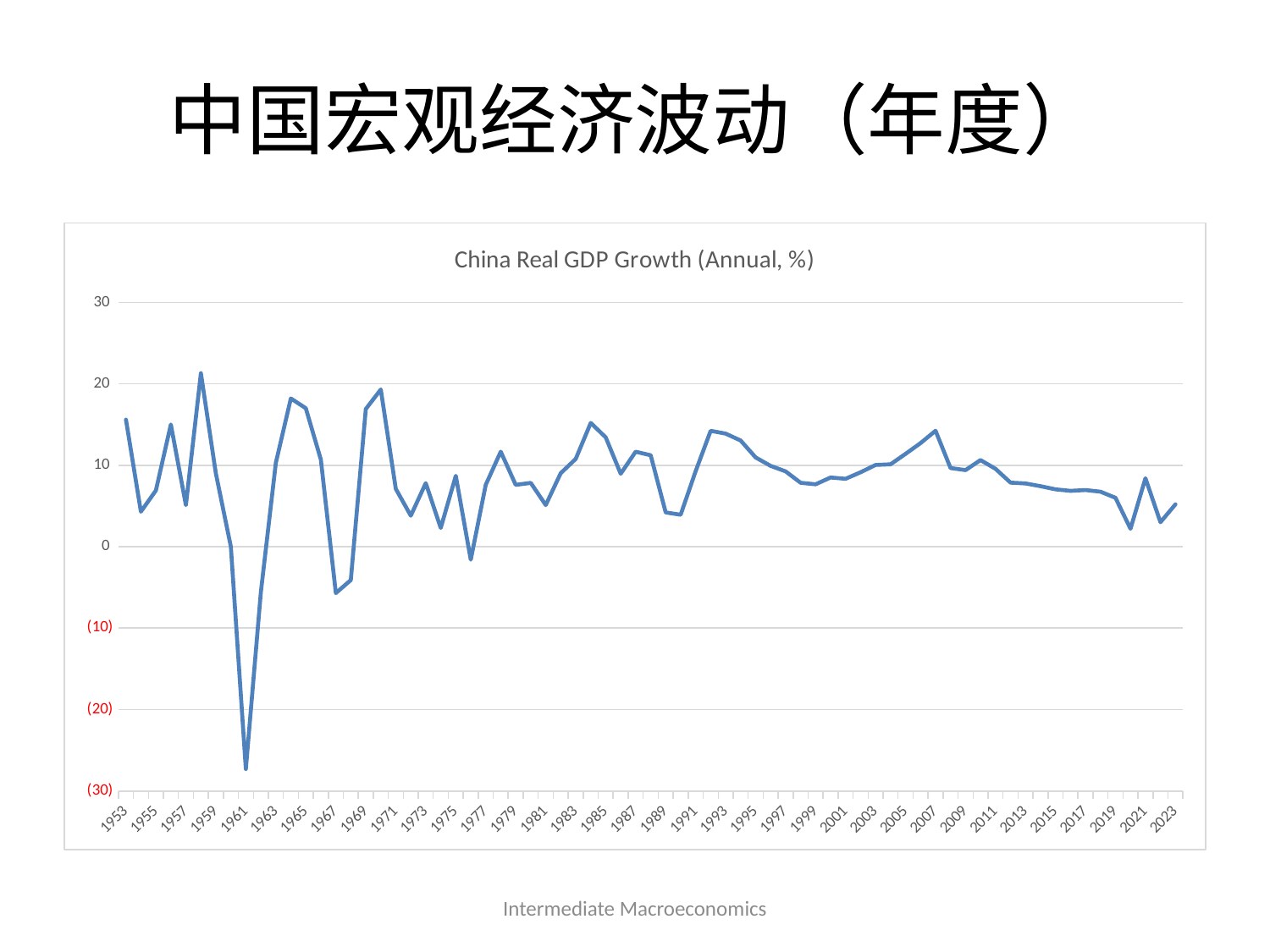
Is the value for 1984 greater or less than 10? greater What kind of chart is shown on the slide? line chart In which year does China's real GDP growth reach its highest point? 1958 In which year does China's real GDP growth reach its lowest point? 1961 Is the value for 2007 greater or less than 10? greater Is the value for 1967 greater or less than 0? less Do the values generally rise or fall from 2007 to 2019? fall Which year has the higher real GDP growth, 1984 or 1990? 1984 How many lines are plotted on the chart? 1 What is the title of the chart? China Real GDP Growth (Annual, %)